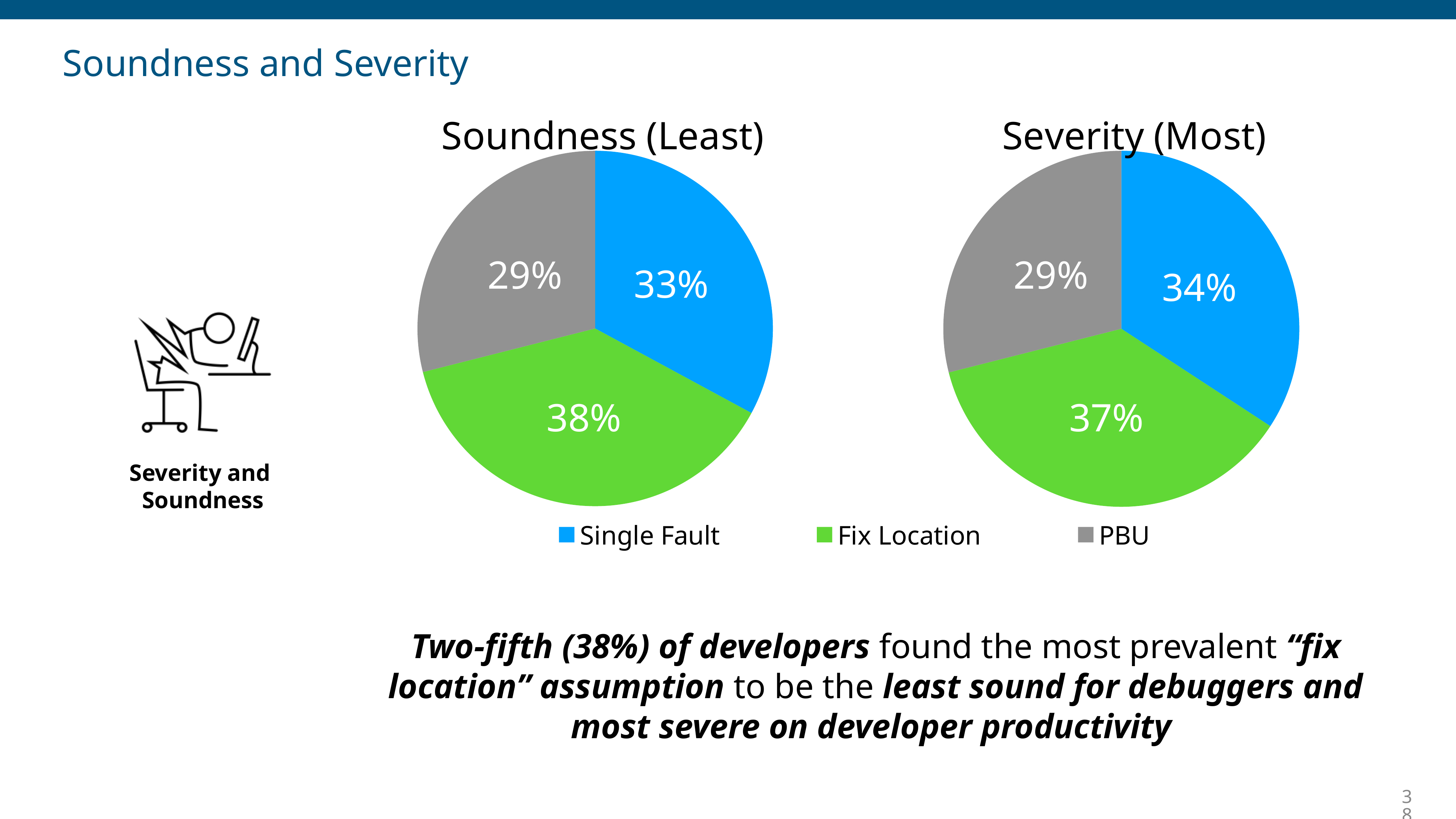
In the "Severity (Most)" chart, which category has the smallest slice? PBU How many slices does the "Severity (Most)" pie chart have? 3 In the "Soundness (Least)" chart, what share does PBU have? 29% In the "Severity (Most)" chart, what share does Single Fault have? 34% In the "Soundness (Least)" chart, what is the difference between the Fix Location and PBU shares? 9% Which colour represents PBU in the legend shared by the two charts? Grey Which is larger in the "Soundness (Least)" chart: Single Fault or PBU? Single Fault In the "Severity (Most)" chart, what share does Fix Location have? 37% In the "Severity (Most)" chart, what is the difference between the Fix Location and Single Fault shares? 3% In the "Soundness (Least)" chart, which category has the largest slice? Fix Location What type of chart is the "Soundness (Least)" chart? Pie chart In the "Soundness (Least)" chart, what share does Fix Location have? 38%